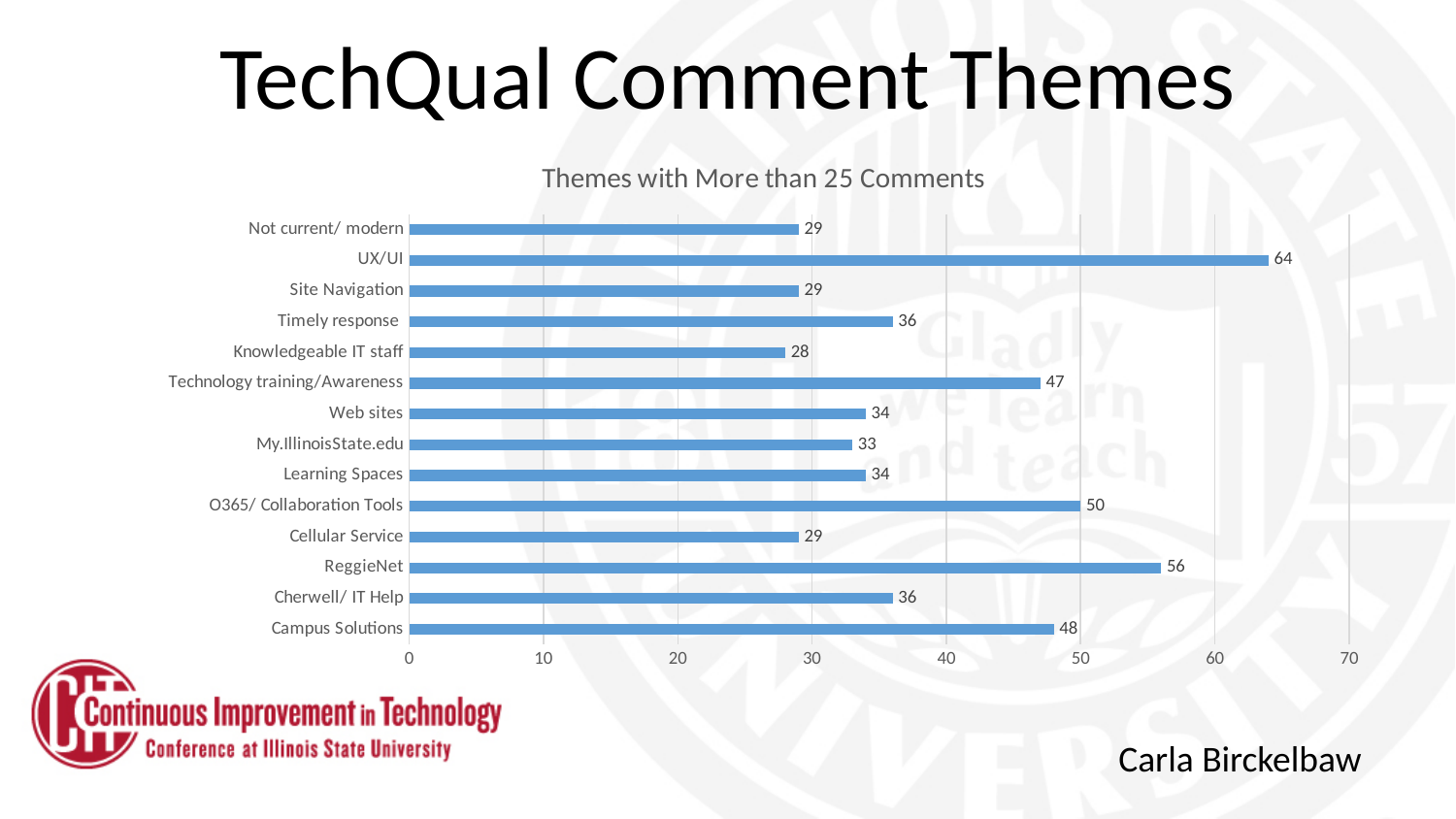
What is the difference between the values for UX/UI and ReggieNet? 8 What is the title of the chart? Themes with More than 25 Comments What is the value for Campus Solutions? 48 How many themes are shown in the chart? 14 What kind of chart is shown on the slide? Bar chart What is the value for ReggieNet? 56 Which theme has the highest number of comments? UX/UI Which theme has the lowest number of comments? Knowledgeable IT staff Is the value for Timely response greater or less than 30? greater What is the value for Technology training/Awareness? 47 Which is larger, the value for O365/ Collaboration Tools or the value for Campus Solutions? O365/ Collaboration Tools What is the value for UX/UI? 64